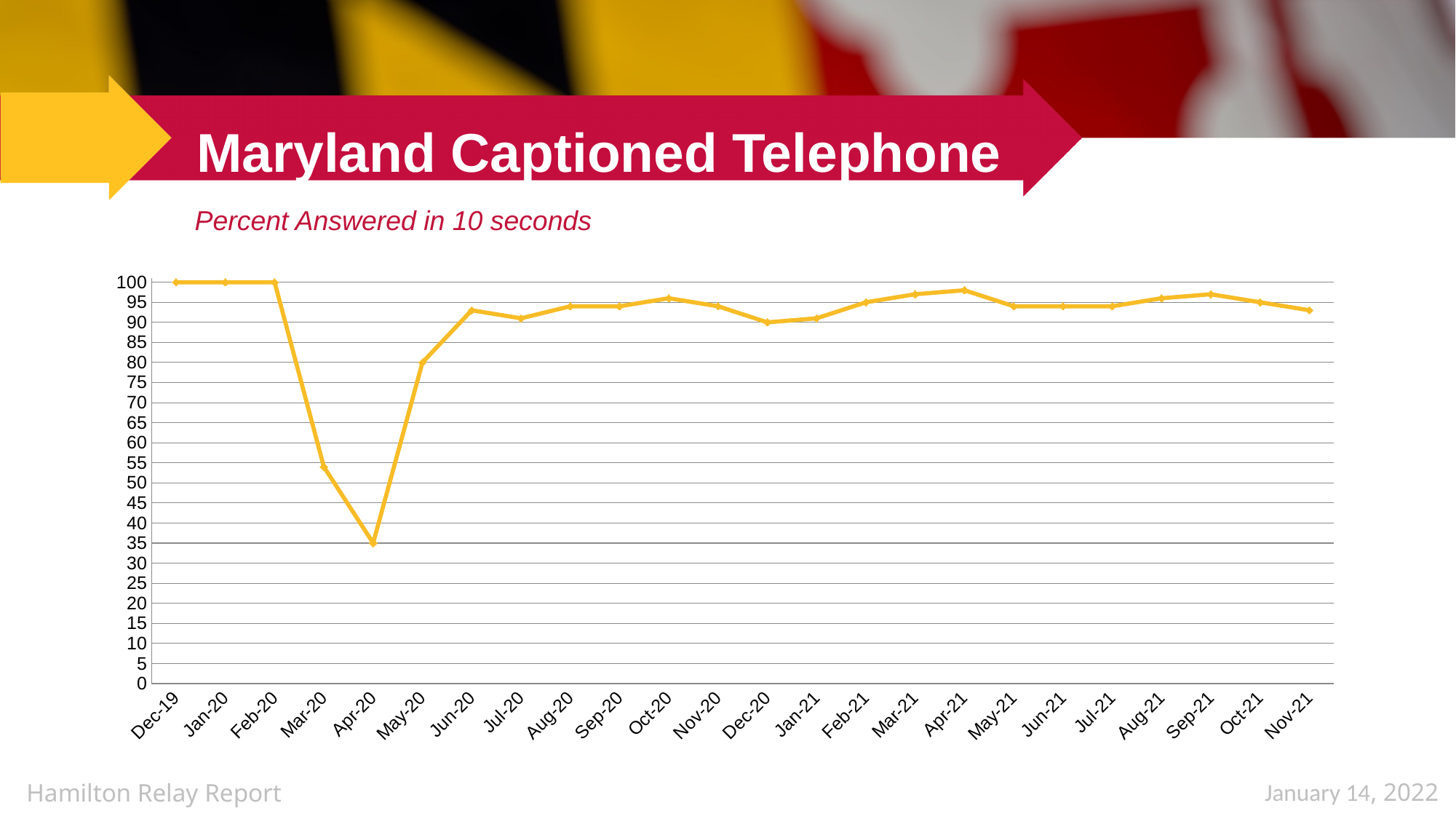
What is the value for Apr-20? 35 What is the value for Dec-19? 100 What does the subtitle say the chart measures? Percent Answered in 10 seconds Is the value for Jun-20 greater or less than 90? greater What kind of chart is shown on the slide? line chart Is the value for Mar-20 greater or less than 60? less How many months are plotted on the x axis? 24 What is the value for May-20? 80 Which month has the lowest value? Apr-20 Do the values rise or fall from Feb-20 to Apr-20? fall Which is larger, the value for Mar-20 or the value for Apr-20? Mar-20 What is the value for Dec-20? 90